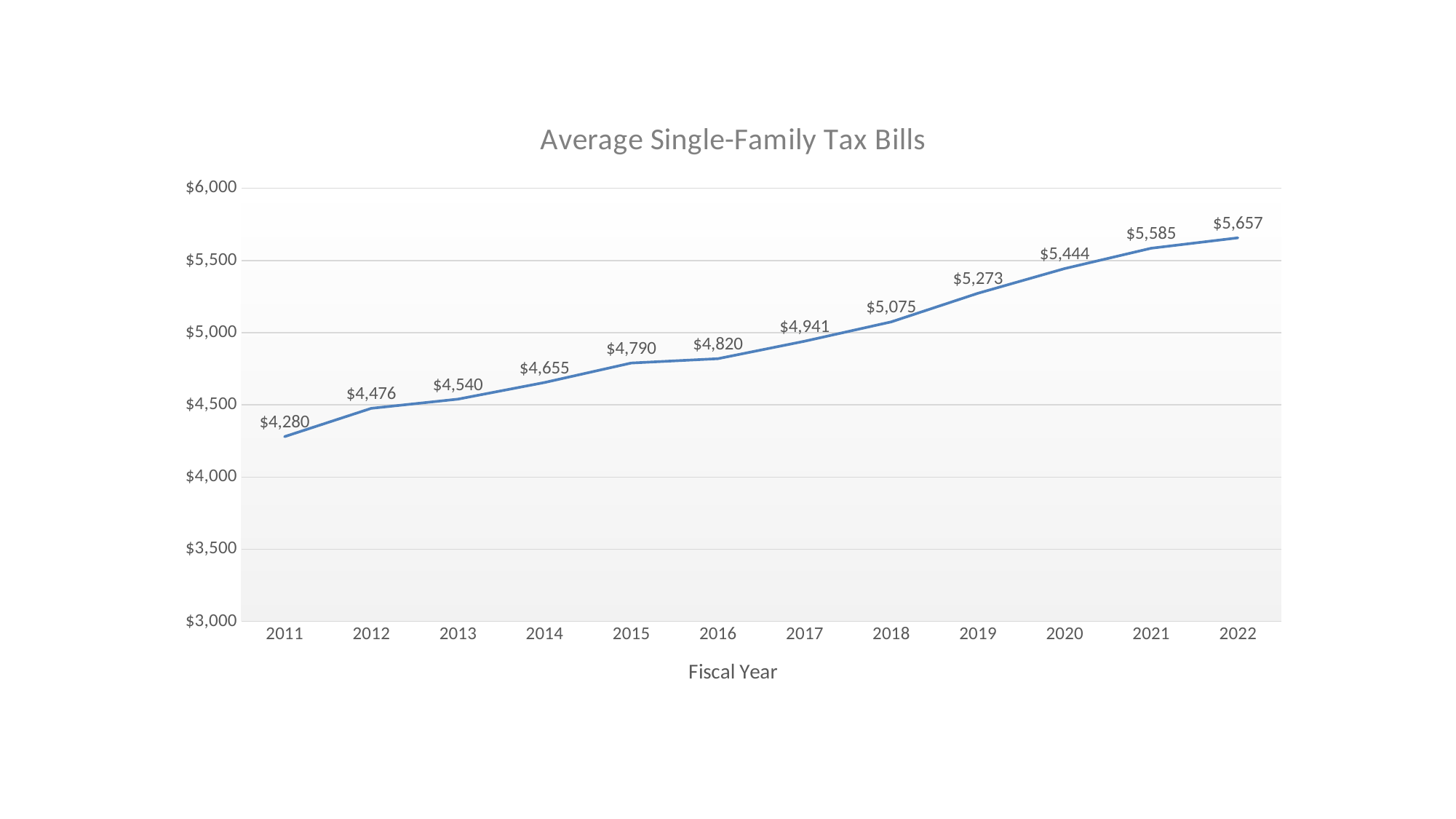
What is the difference between the average tax bill in 2022 and in 2011? $1,377 Which fiscal year has a larger average tax bill, 2018 or 2020? 2020 What is the average single-family tax bill for fiscal year 2011? $4,280 What is the average single-family tax bill for fiscal year 2017? $4,941 Which fiscal year has the highest average single-family tax bill? 2022 How many fiscal years are plotted on the chart? 12 Do the average tax bills rise or fall from 2011 to 2022? Rise What is the average single-family tax bill for fiscal year 2022? $5,657 Is the average tax bill for 2019 greater or less than $5,000? greater What kind of chart is shown on the slide? Line chart Which fiscal year has the lowest average single-family tax bill? 2011 What is the difference between the average tax bill in 2016 and in 2015? $30